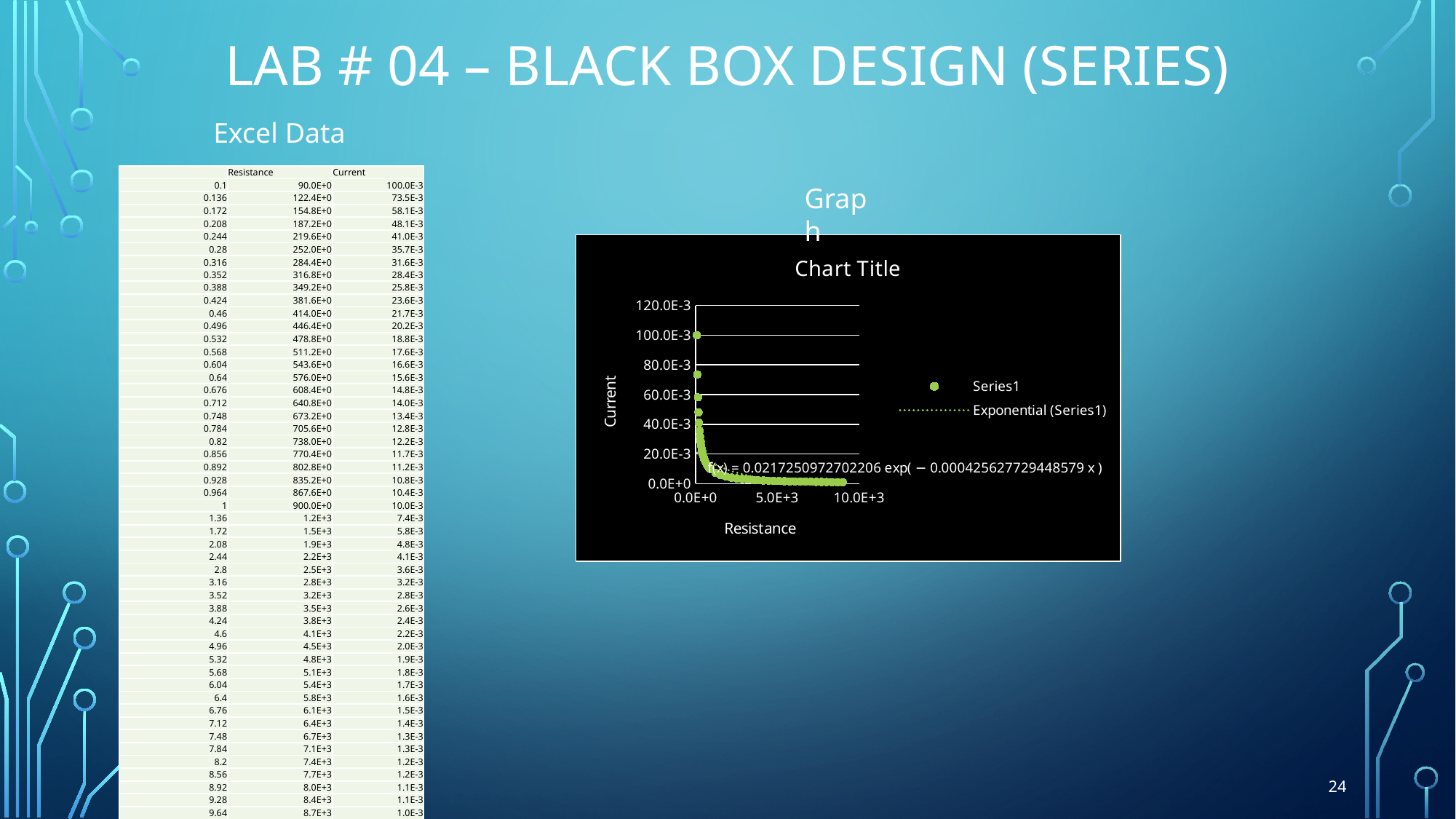
As Resistance increases along the x axis, do the Current values rise or fall? fall What is the highest tick value shown on the chart's y axis? 120.0E-3 How many entries does the chart's legend list? 2 Is the Current value plotted at a Resistance of 5.0E+3 greater or less than 20.0E-3? less What is the exponent coefficient of x in the fitted trendline equation shown on the chart? -0.000425627729448579 What kind of chart is shown on the slide? scatter chart What is the label of the chart's x axis? Resistance What is the multiplying coefficient in the fitted trendline equation f(x) shown on the chart? 0.0217250972702206 Is the highest plotted Current value greater or less than 80.0E-3? greater What is the title of the chart? Chart Title